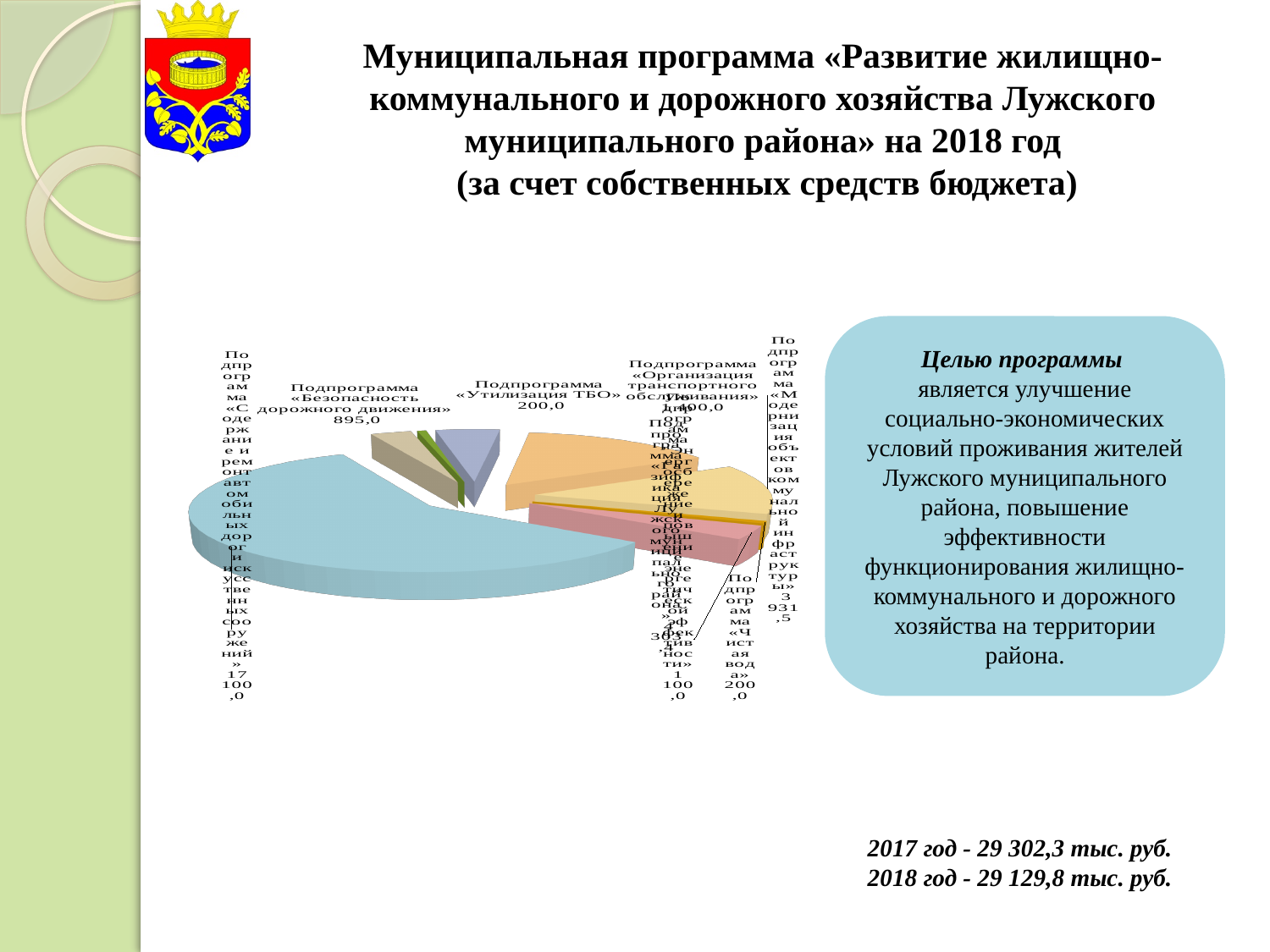
What is the difference between the values for «Модернизация объектов коммунальной инфраструктуры» and «Безопасность дорожного движения»? 3 036,5 Which subprogram has the largest slice of the pie? Подпрограмма «Содержание и ремонт автомобильных дорог и искусственных сооружений» Which is larger: the value for «Модернизация объектов коммунальной инфраструктуры» or for «Безопасность дорожного движения»? «Модернизация объектов коммунальной инфраструктуры» Which is larger: the value for «Безопасность дорожного движения» or for «Утилизация ТБО»? «Безопасность дорожного движения» What kind of chart is shown on the slide? pie chart What value is shown for the subprogram «Чистая вода»? 200,0 What is the difference between the values for «Безопасность дорожного движения» and «Утилизация ТБО»? 695,0 What colour is the largest slice of the pie chart? light blue What value is shown for the subprogram «Модернизация объектов коммунальной инфраструктуры»? 3 931,5 What value is shown for the subprogram «Содержание и ремонт автомобильных дорог и искусственных сооружений»? 17 100,0 What value is shown for the subprogram «Утилизация ТБО»? 200,0 What value is shown for the subprogram «Безопасность дорожного движения»? 895,0